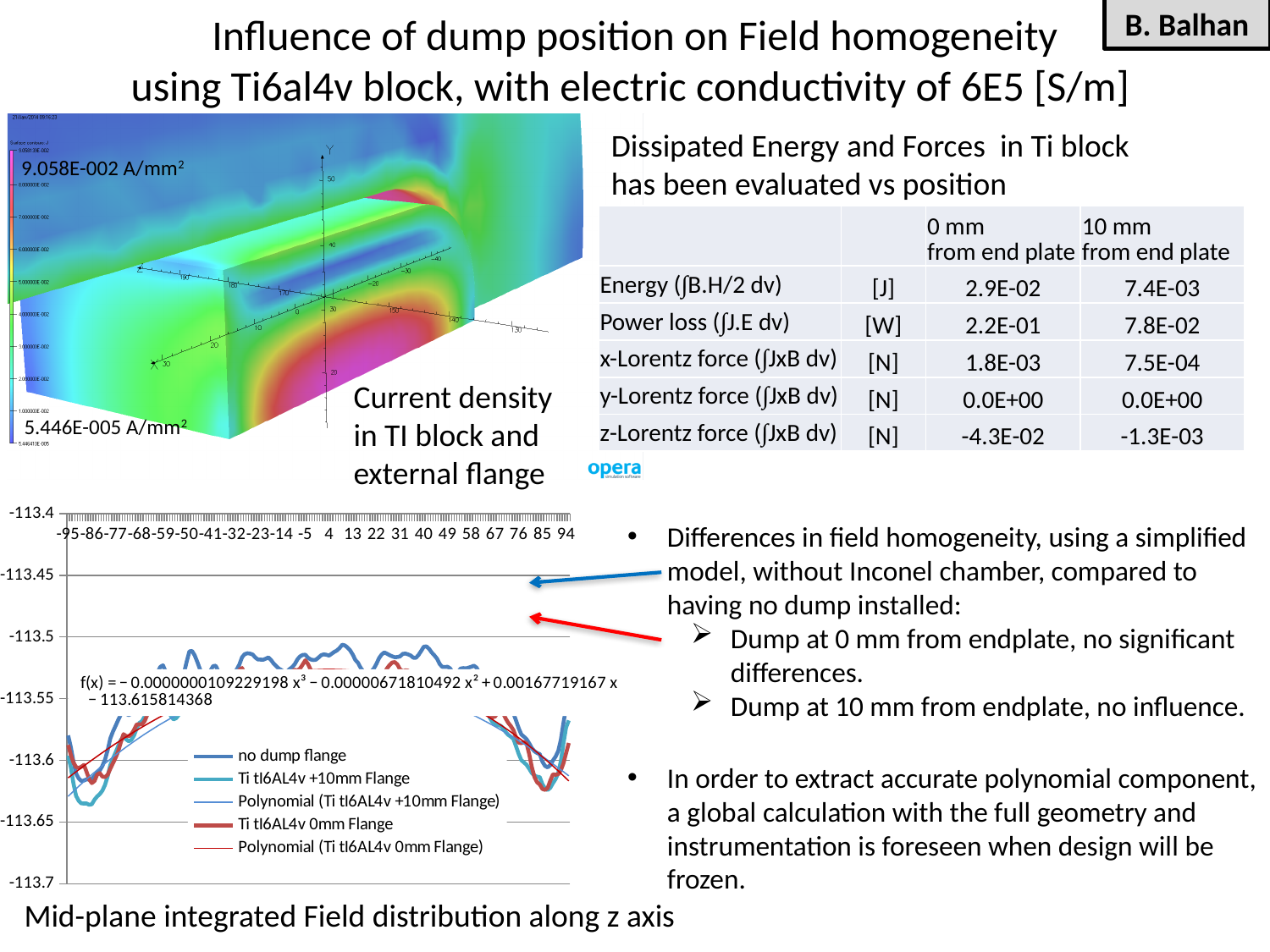
In the 'Mid-plane integrated Field distribution along z axis' chart, is the value of the 'Ti tI6AL4v 0mm Flange' series at x = -95 greater or less than -113.55? less What kind of chart is the 'Mid-plane integrated Field distribution along z axis' chart at the bottom left of the slide? line chart In the 'Mid-plane integrated Field distribution along z axis' chart, does the 'Ti tI6AL4v 0mm Flange' series rise or fall between x = 40 and x = 85? fall In the 'Mid-plane integrated Field distribution along z axis' chart, what is the lowest value shown on the y axis? -113.7 In the 'Mid-plane integrated Field distribution along z axis' chart, what is the first x-axis label on the left? -95 In the 'Mid-plane integrated Field distribution along z axis' chart, what is the last x-axis label on the right? 94 How many series does the legend of the 'Mid-plane integrated Field distribution along z axis' chart list? 5 In the 'Mid-plane integrated Field distribution along z axis' chart, what is the highest value shown on the y axis? -113.4 On the current density plot at the top left of the slide, what is the maximum value labelled on the colour scale? 9.058E-002 A/mm² In the 'Mid-plane integrated Field distribution along z axis' chart, is the value of the 'no dump flange' series at x = 4 greater or less than -113.55? greater In the 'Mid-plane integrated Field distribution along z axis' chart, is the value of the 'Ti tI6AL4v +10mm Flange' series at x = 94 greater or less than -113.5? less In the 'Mid-plane integrated Field distribution along z axis' chart, does the 'no dump flange' series rise or fall between x = -77 and x = 4? rise